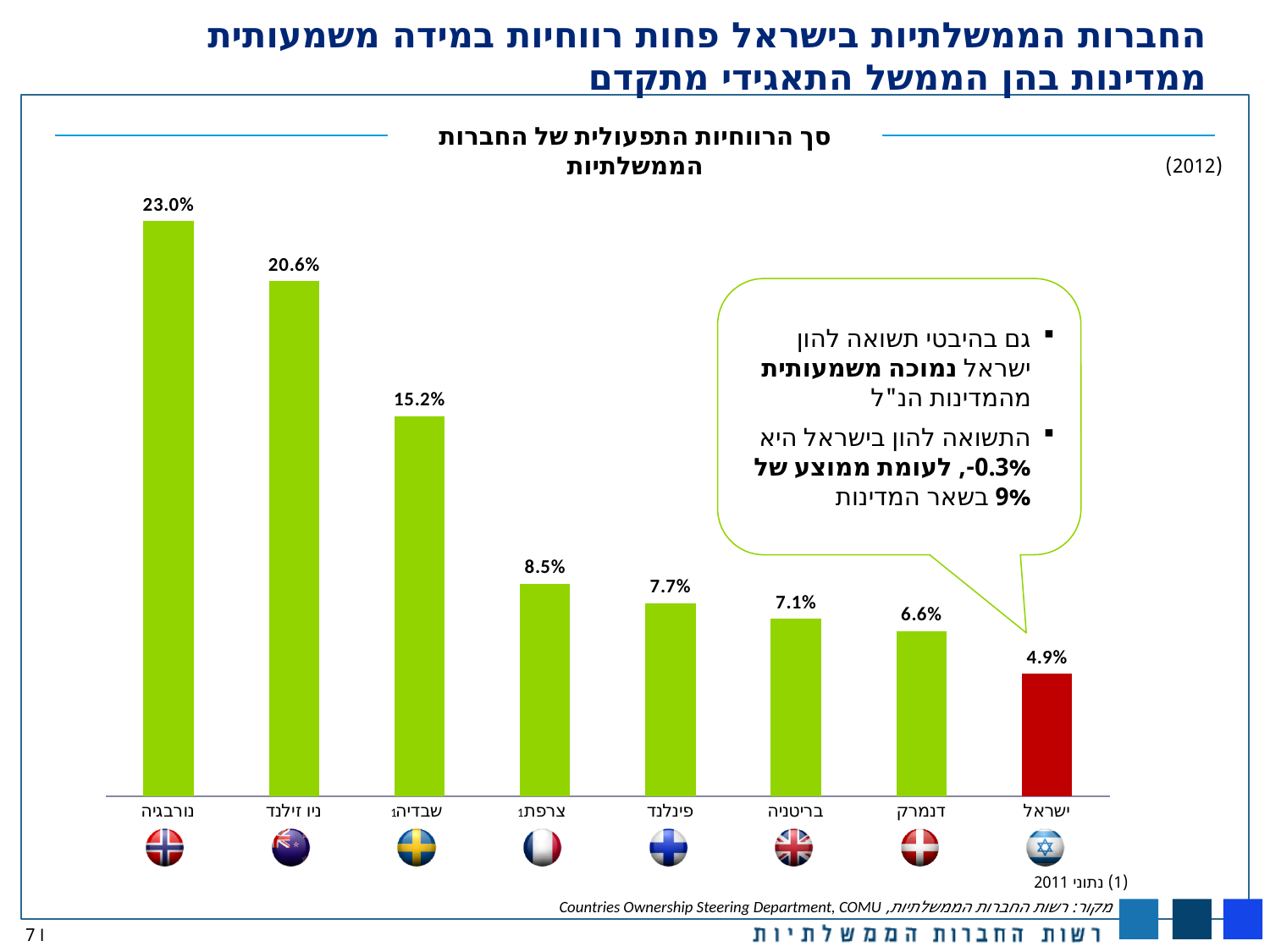
What is the value shown for ישראל (Israel)? 4.9% Which is larger, the value for צרפת (France) or the value for דנמרק (Denmark)? צרפת (France) How many countries are shown in the chart? 8 What is the value shown for שבדיה (Sweden)? 15.2% What is the value shown for נורבגיה (Norway)? 23.0% Which country has the lowest value in the chart? ישראל (Israel) What is the difference between the values for ניו זילנד (New Zealand) and שבדיה (Sweden)? 5.4% What is the difference between the values for נורבגיה (Norway) and ישראל (Israel)? 18.1% What kind of chart is shown on the slide? Bar chart What is the value shown for פינלנד (Finland)? 7.7% Which country has the highest value in the chart? נורבגיה (Norway) Which bar is coloured red instead of green? ישראל (Israel)